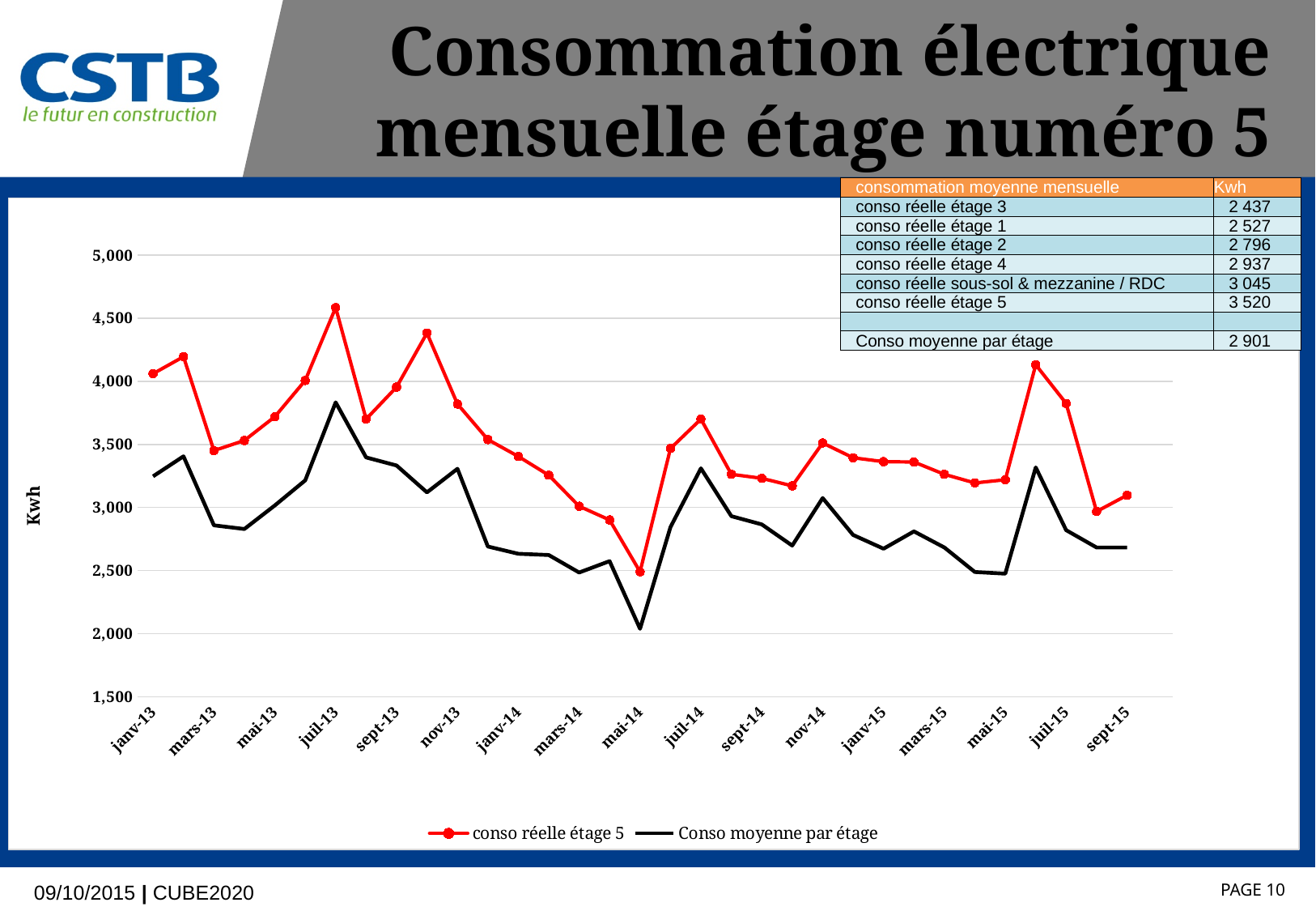
In which month does the 'Conso moyenne par étage' series reach its lowest value? mai-14 How many series does the chart legend list? 2 Does the 'conso réelle étage 5' series rise or fall between mai-14 and juil-14? rise Is the value of 'Conso moyenne par étage' in mai-14 greater or less than 2,500? less What are the two series named in the chart legend? conso réelle étage 5 and Conso moyenne par étage In which month does the 'conso réelle étage 5' series reach its lowest value? mai-14 In juil-13, which series has the higher value, 'conso réelle étage 5' or 'Conso moyenne par étage'? conso réelle étage 5 In which month does the 'conso réelle étage 5' series reach its highest value? juil-13 What is the label on the chart's vertical axis? Kwh Is the value of 'conso réelle étage 5' in juil-13 greater or less than 4,000? greater Is the value of 'conso réelle étage 5' in mai-14 greater or less than 3,000? less What kind of chart is shown on the slide? line chart